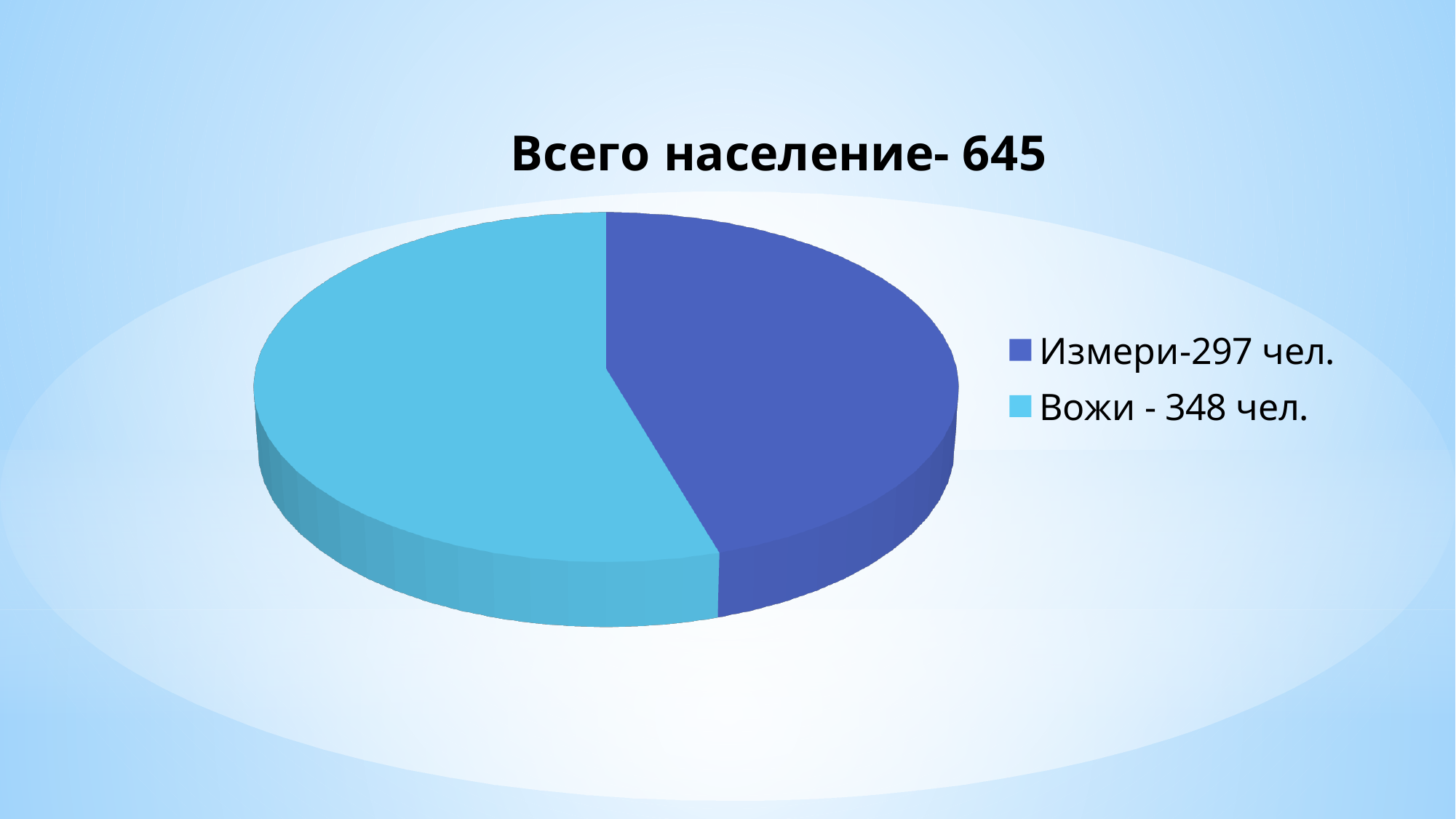
Which is larger, the value for Измери or the value for Вожи? Вожи What type of chart is shown on the slide? pie chart How many slices does the pie chart have? 2 Which category has the larger slice of the pie? Вожи How many people are shown for Измери? 297 чел. Which category has the smaller slice of the pie? Измери How many entries does the legend list? 2 What colour is the slice for Вожи? light blue What is the title of the chart? Всего население- 645 What is the difference between the values for Вожи and Измери? 51 How many people are shown for Вожи? 348 чел. What is the total population shown in the chart title? 645